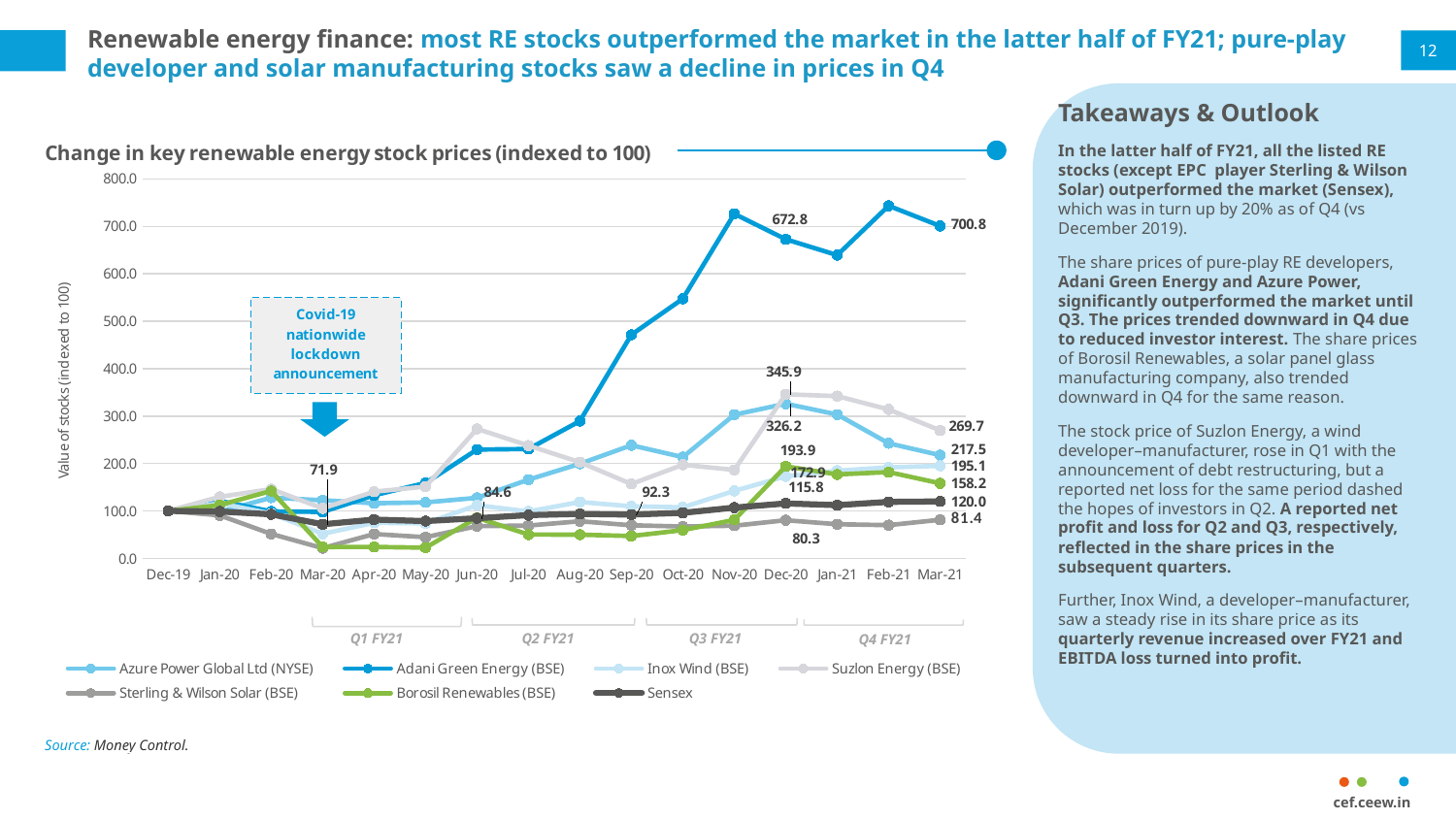
Which series has the lowest value in Mar-21? Sterling & Wilson Solar (BSE) What type of chart is shown on the slide? Line chart Which is larger in Mar-21: Inox Wind (BSE) or Borosil Renewables (BSE)? Inox Wind (BSE) Is the value for Adani Green Energy (BSE) in Sep-20 greater or less than 400.0? greater What is the value for Sensex in Mar-21? 120.0 What is the value for Adani Green Energy (BSE) in Mar-21? 700.8 By how much did Adani Green Energy (BSE) change from Dec-20 (672.8) to Mar-21 (700.8)? 28.0 What is the value for Adani Green Energy (BSE) in Dec-20? 672.8 Which series has the highest value in Mar-21? Adani Green Energy (BSE) What is the value for Suzlon Energy (BSE) in Mar-21? 269.7 How many months are shown on the x axis? 16 How many series does the legend list? 7